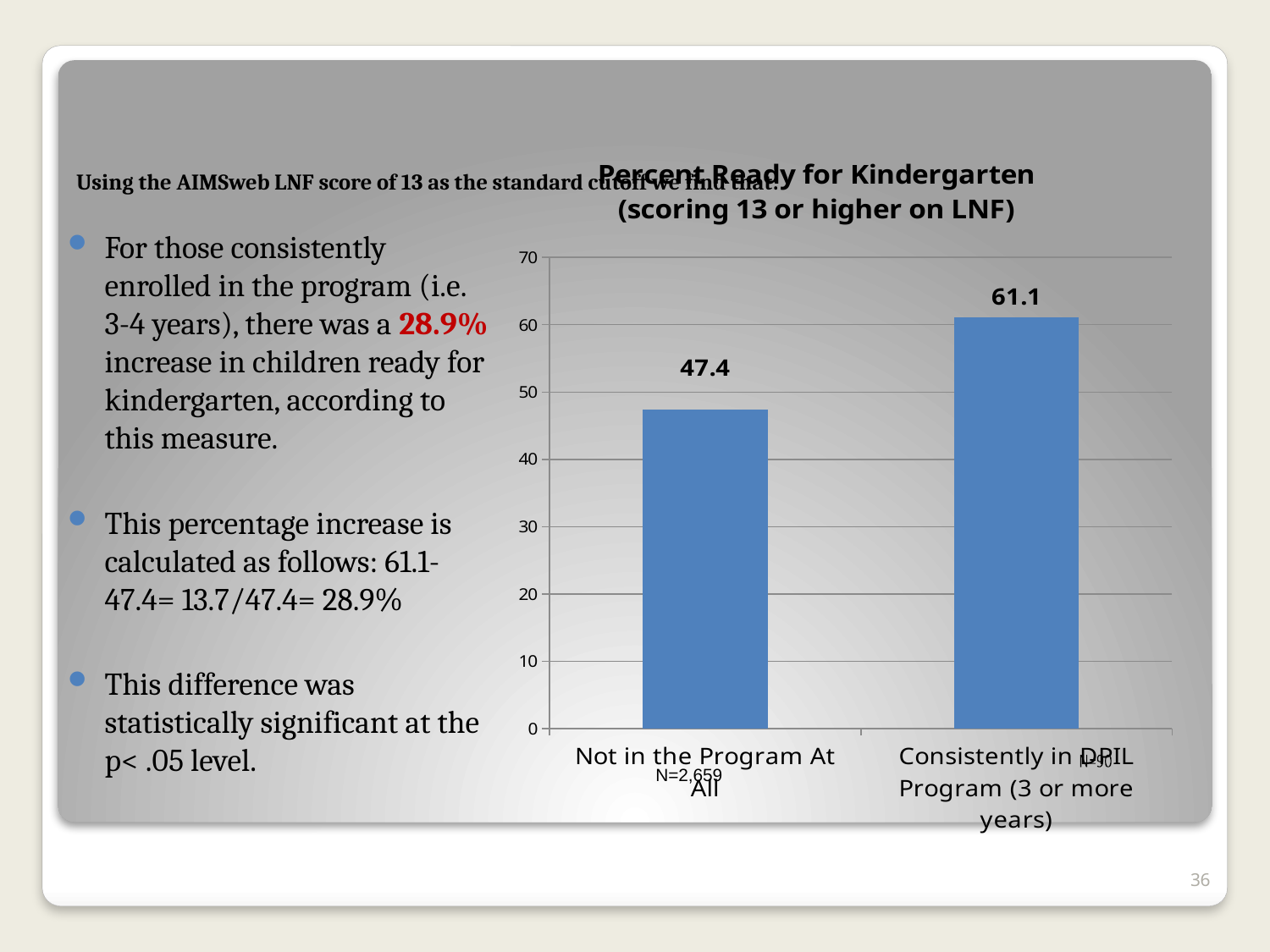
Is the value for "Consistently in DPIL Program (3 or more years)" greater or less than 60? greater What is the difference between the values for "Consistently in DPIL Program (3 or more years)" and "Not in the Program At All"? 13.7 Which category has the lowest value? Not in the Program At All What is the value for "Not in the Program At All"? 47.4 What kind of chart is shown on the slide? Bar chart Which category has the highest value? Consistently in DPIL Program (3 or more years) How many categories are shown in the chart? 2 What is the value for "Consistently in DPIL Program (3 or more years)"? 61.1 What is the title of the chart? Percent Ready for Kindergarten (scoring 13 or higher on LNF) Is the value for "Not in the Program At All" greater or less than 50? less Which is larger: the value for "Not in the Program At All" or for "Consistently in DPIL Program (3 or more years)"? Consistently in DPIL Program (3 or more years) What is the maximum value shown on the vertical axis? 70